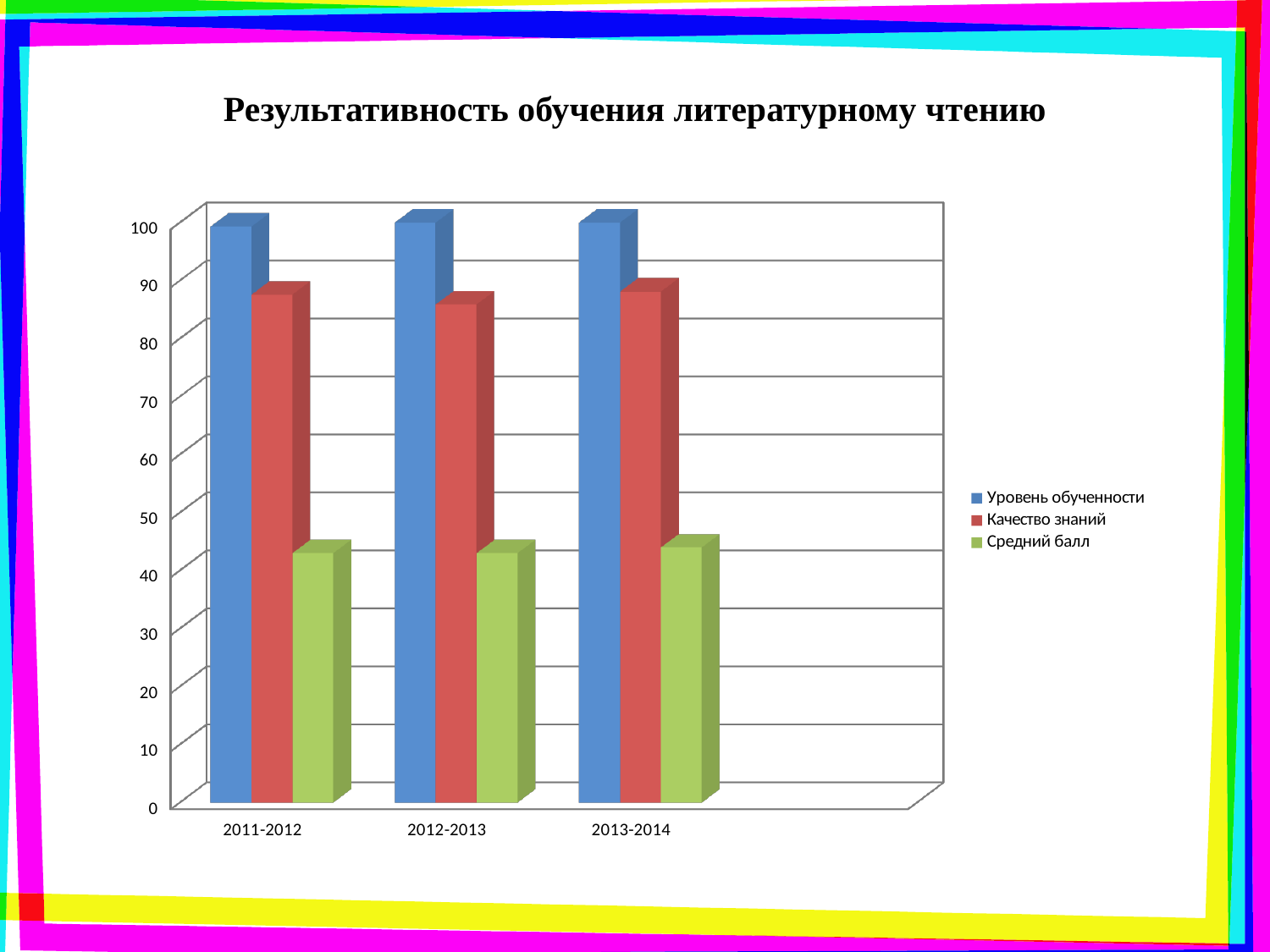
What is the title of the chart? Результативность обучения литературному чтению In 2012-2013, which is larger: Уровень обученности or Средний балл? Уровень обученности How many school-year categories are shown on the x axis? 3 Is the value for Средний балл in 2012-2013 greater or less than 30? greater Which colour represents Средний балл in the legend? Green Is the value for Средний балл in 2013-2014 greater or less than 50? less Which series has the lowest value in 2011-2012? Средний балл Is the value for Уровень обученности in 2011-2012 greater or less than 90? greater What kind of chart is shown on the slide? Bar chart Which series has the highest value in 2013-2014? Уровень обученности How many series does the legend list? 3